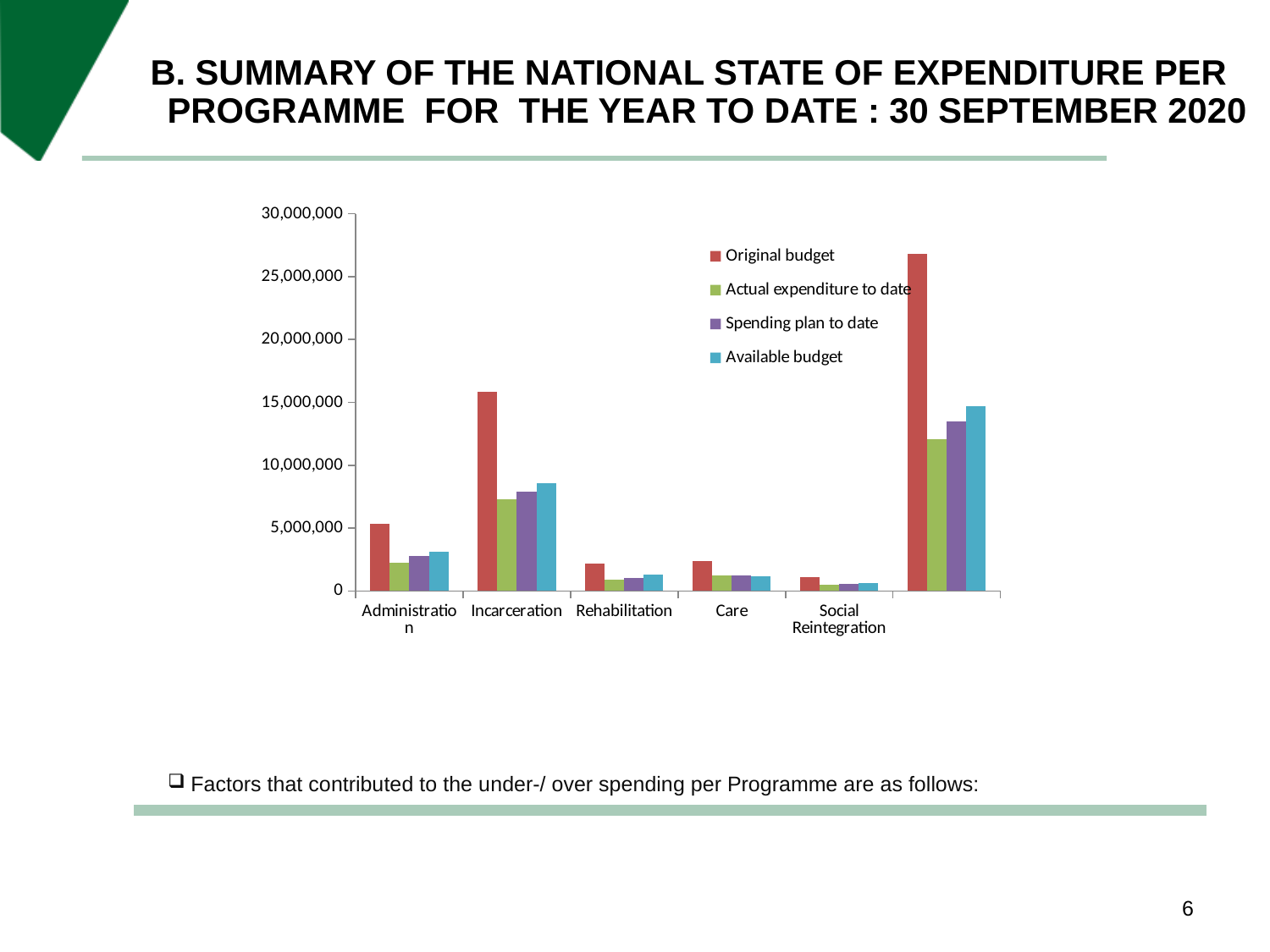
Is the Original budget for Administration greater or less than 10,000,000? less Is the Available budget for Incarceration greater or less than 10,000,000? less Is the Original budget for Incarceration greater or less than 10,000,000? greater What kind of chart is shown on the slide? Bar chart Among the labelled programmes, which has the lowest Original budget? Social Reintegration Which is larger, the Original budget for Incarceration or the Original budget for Administration? Incarceration Among the labelled programmes, which has the highest Original budget? Incarceration Which series is shown in red in the chart legend? Original budget How many series does the chart legend list? 4 Which series is listed last in the chart legend? Available budget For Incarceration, which is larger, the Available budget or the Actual expenditure to date? Available budget